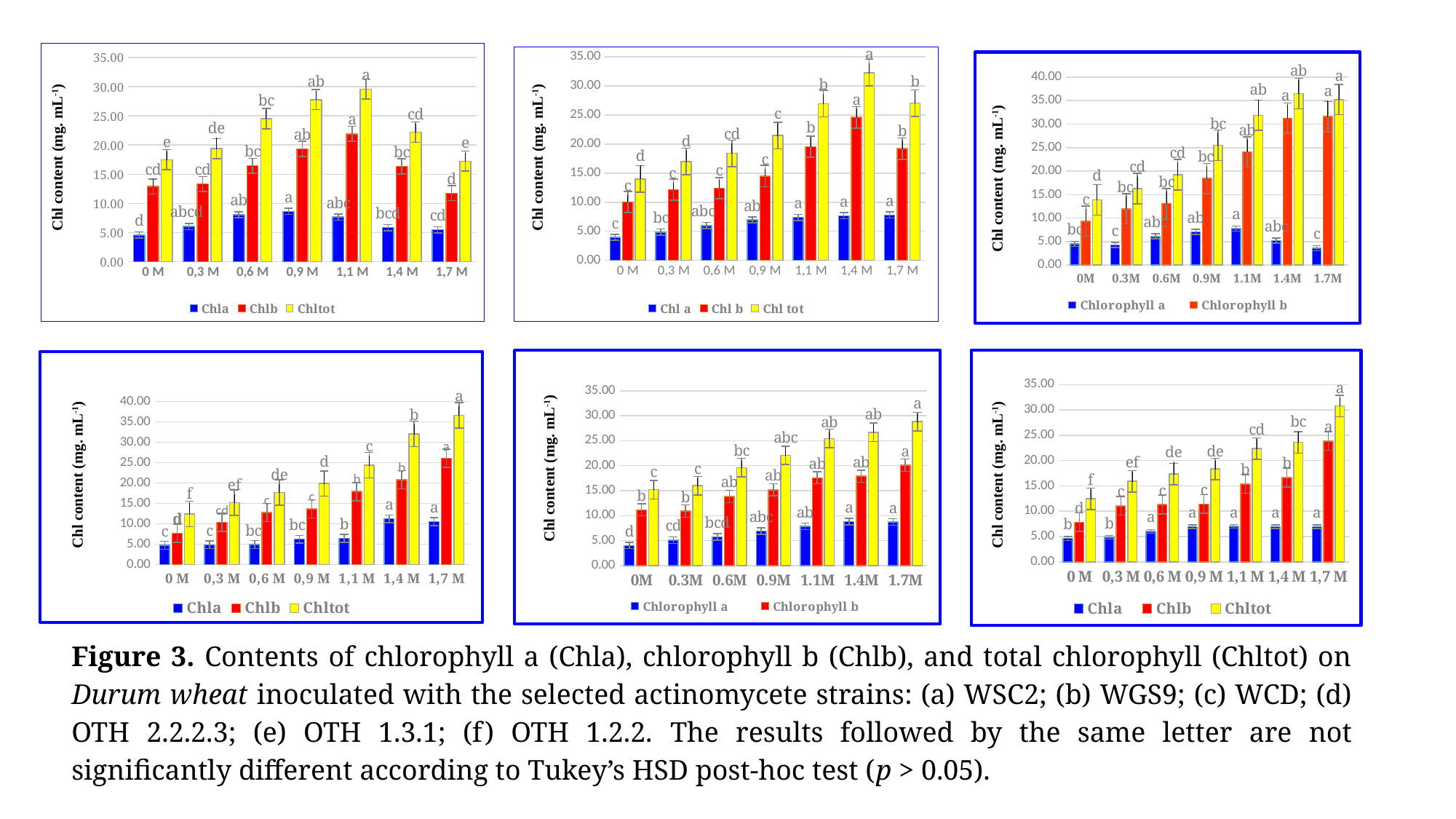
In the top-middle chart, is the Chl b value for 1,4 M greater or less than 20? greater What kind of chart is the top-left chart? bar chart In the top-left chart, which is larger, the Chlb value for 1,1 M or for 1,4 M? 1,1 M How many series does the legend of the top-right chart list? 2 In the top-middle chart, which category has the highest Chl tot value? 1,4 M In the bottom-left chart, which category has the highest Chltot value? 1,7 M In the bottom-middle chart, is the Chlorophyll b value for 1.7M greater or less than 15? greater In the top-left chart, is the Chltot value for 1,1 M greater or less than 25? greater How many categories are shown on the x axis of the top-left chart? 7 In the bottom-right chart, which category has the lowest Chltot value? 0 M How many series does the legend of the top-left chart list? 3 In the bottom-left chart, do the Chltot values rise or fall from 0 M to 1,7 M? rise